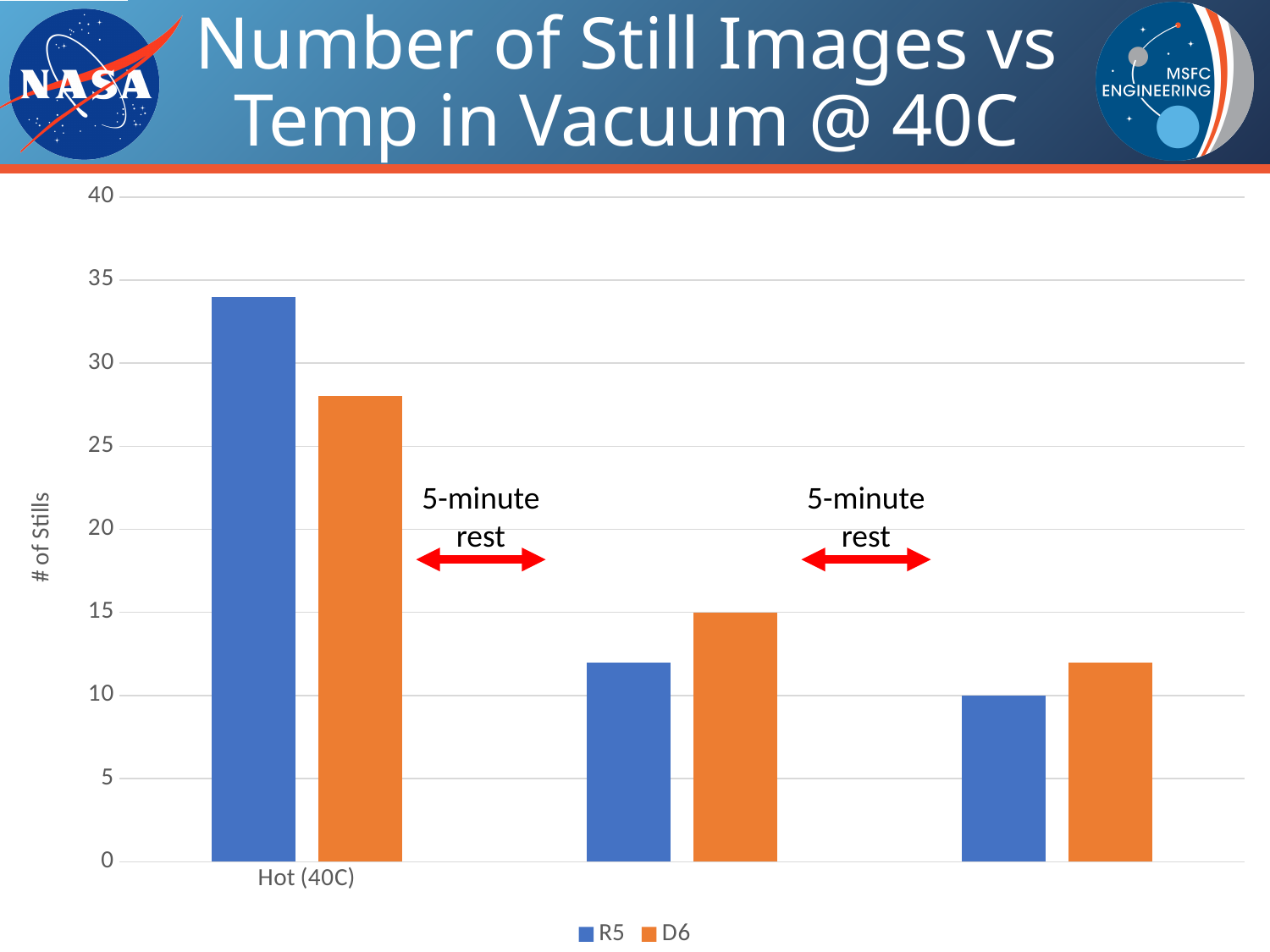
Is the D6 value for Hot (40C) greater or less than 25? greater Which bar on the chart is the tallest? R5 at Hot (40C) How many series does the legend list? 2 Do the R5 values rise or fall from left to right across the groups? fall Is the D6 value for Hot (40C) greater or less than 30? less What kind of chart is shown on the slide? bar chart What are the two series named in the legend? R5 and D6 For Hot (40C), which series has the larger value, R5 or D6? R5 How many groups of bars are plotted on the chart? 3 Is the R5 value for Hot (40C) greater or less than 30? greater Which series has the lowest bar on the chart? R5 What is the label on the vertical axis? # of Stills